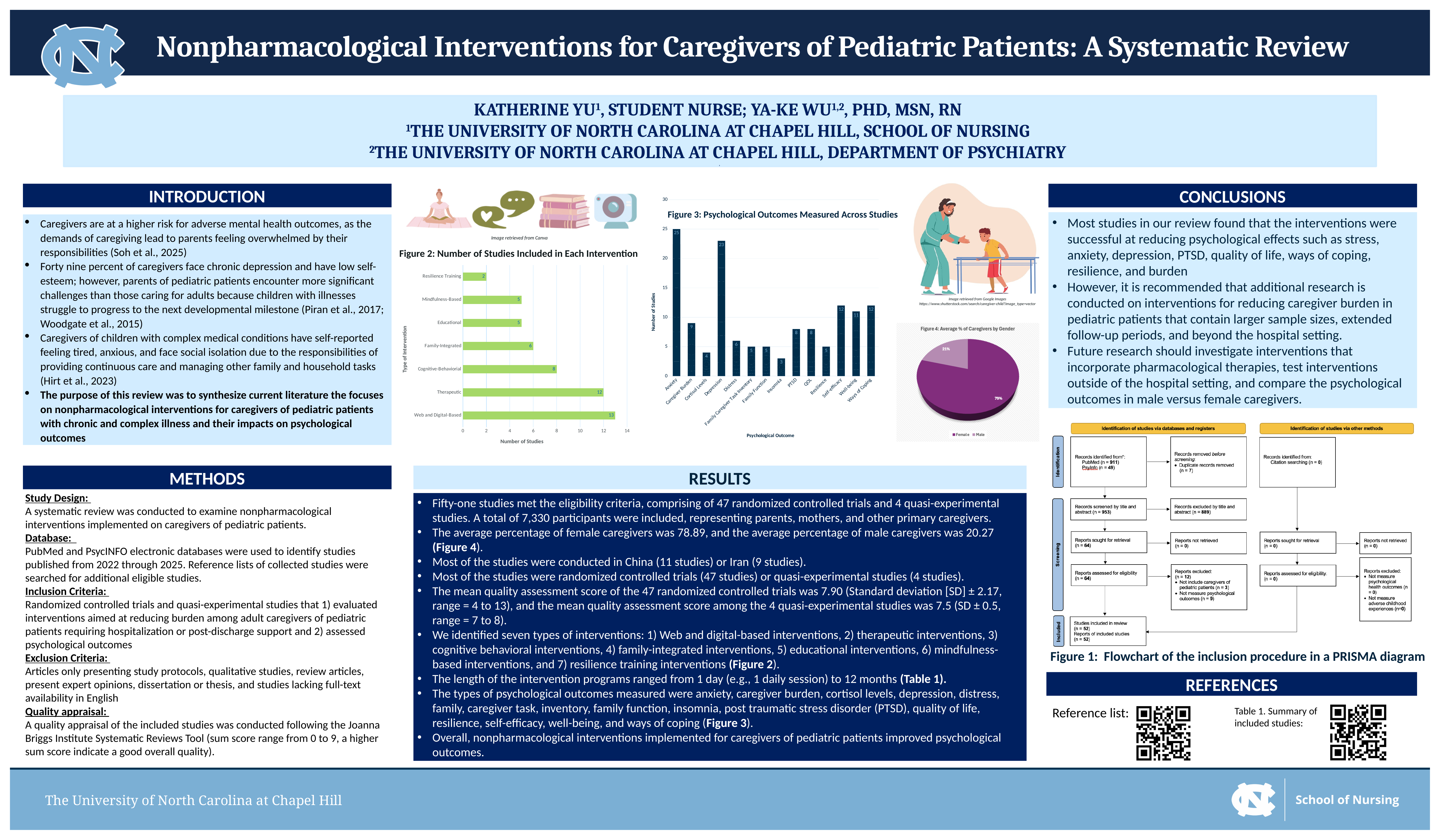
In Figure 3, how many psychological outcomes are shown on the x axis? 14 How many series does the legend of Figure 4 list? 2 In Figure 3, which psychological outcome was measured in the fewest studies? Insomnia In Figure 2, which intervention type has the fewest studies? Resilience Training In Figure 2 (Number of Studies Included in Each Intervention), how many studies are Web and Digital-Based? 13 In Figure 3 (Psychological Outcomes Measured Across Studies), how many studies measured Depression? 23 What kind of chart is Figure 2? Bar chart In Figure 3, which was measured in more studies, Caregiver Burden or Cortisol Levels? Caregiver Burden In Figure 2, how many intervention types are shown? 7 In Figure 2, what is the difference in number of studies between Therapeutic and Cognitive-Behavioral interventions? 4 In Figure 3, which psychological outcome was measured in the most studies? Anxiety In Figure 4 (Average % of Caregivers by Gender), what share of the pie is Female? 79%